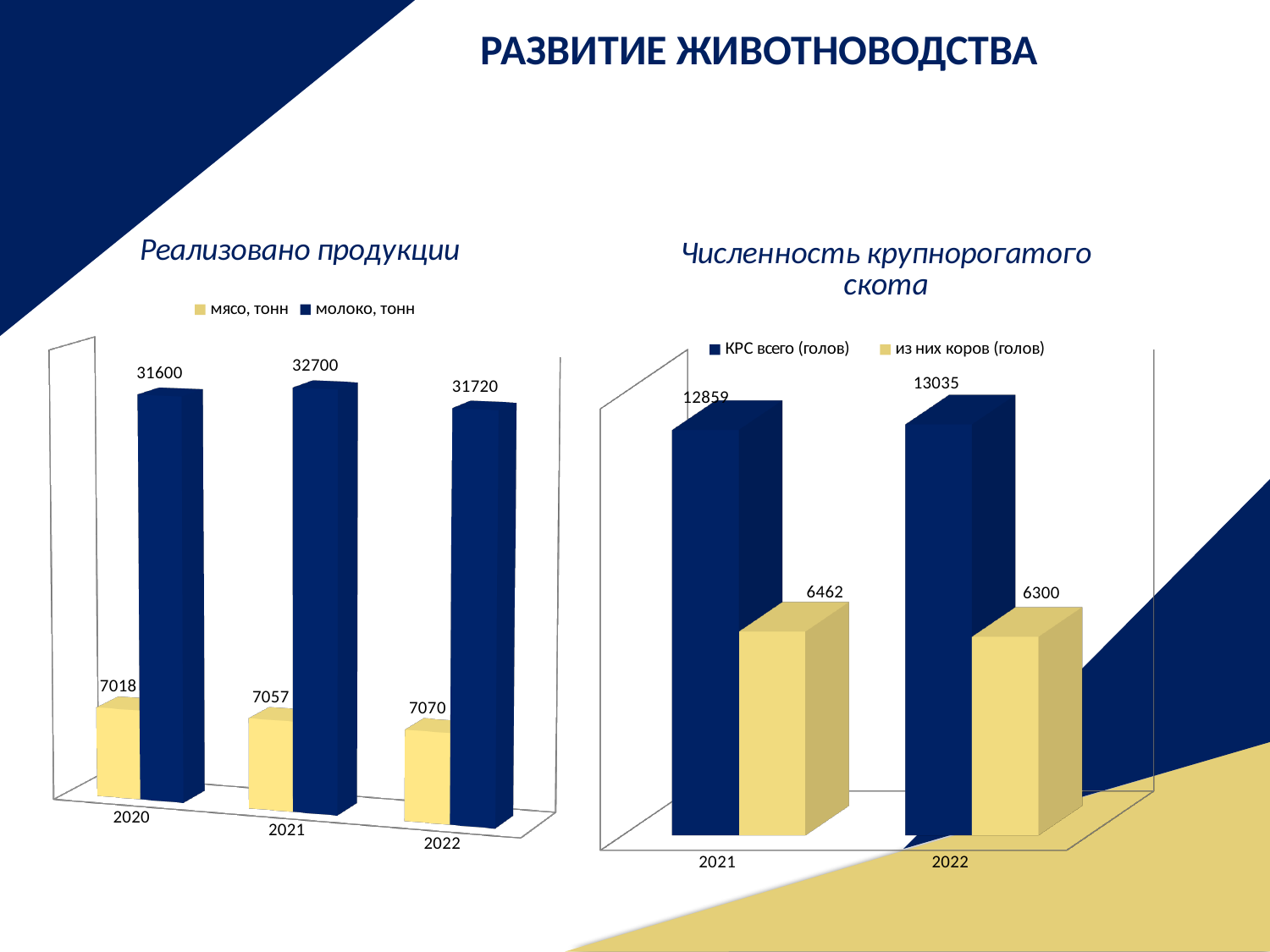
What kind of chart is the 'Численность крупнорогатого скота' chart? bar chart In the 'Численность крупнорогатого скота' chart, what is the value for КРС всего (голов) in 2022? 13035 In the 'Реализовано продукции' chart, what is the difference between молоко, тонн in 2021 and in 2020? 1100 In the 'Численность крупнорогатого скота' chart, what is the difference between КРС всего (голов) in 2022 and in 2021? 176 In the 'Реализовано продукции' chart, which year has the highest value for молоко, тонн? 2021 In the 'Реализовано продукции' chart, which year has the lowest value for мясо, тонн? 2020 In the 'Численность крупнорогатого скота' chart, what is the value for из них коров (голов) in 2021? 6462 In the 'Реализовано продукции' chart, what is the value for мясо, тонн in 2020? 7018 In the 'Реализовано продукции' chart, how many years are shown on the x axis? 3 In the 'Численность крупнорогатого скота' chart, does the value for из них коров (голов) rise or fall from 2021 to 2022? fall In the 'Реализовано продукции' chart, what is the value for молоко, тонн in 2021? 32700 In the 'Реализовано продукции' chart, how many series does the legend list? 2